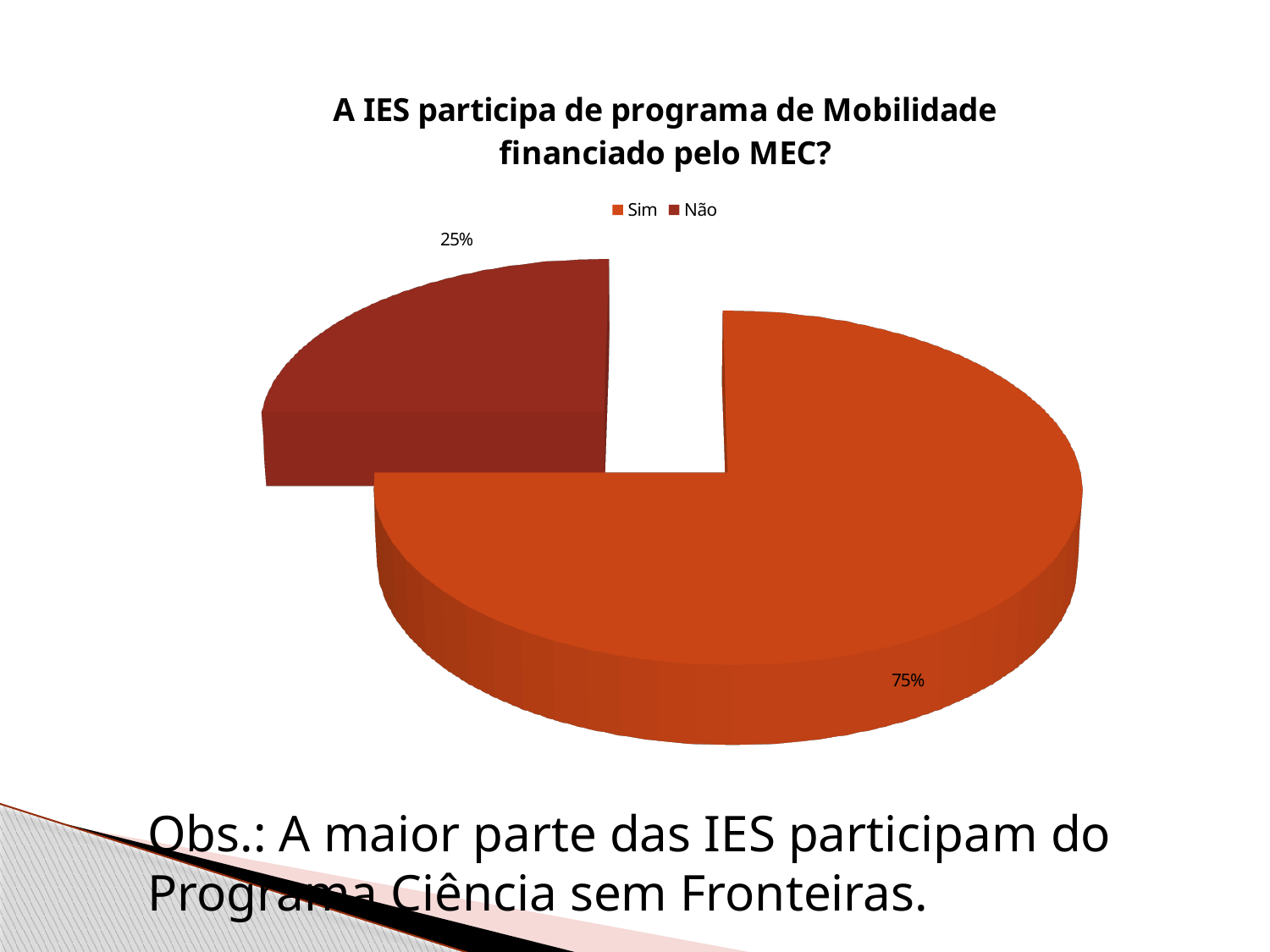
What is the difference in percentage points between the "Sim" and "Não" slices? 50% What share of the pie does the "Sim" slice represent? 75% How many slices does the pie chart have? 2 How many entries does the legend list? 2 What kind of chart is shown on the slide? Pie chart Which legend entry is shown in the darker red colour? Não Which category has the smallest slice of the pie? Não Which category has the largest slice of the pie? Sim Which is larger, the "Sim" slice or the "Não" slice? Sim What is the title of the chart? A IES participa de programa de Mobilidade financiado pelo MEC? What share of the pie does the "Não" slice represent? 25%